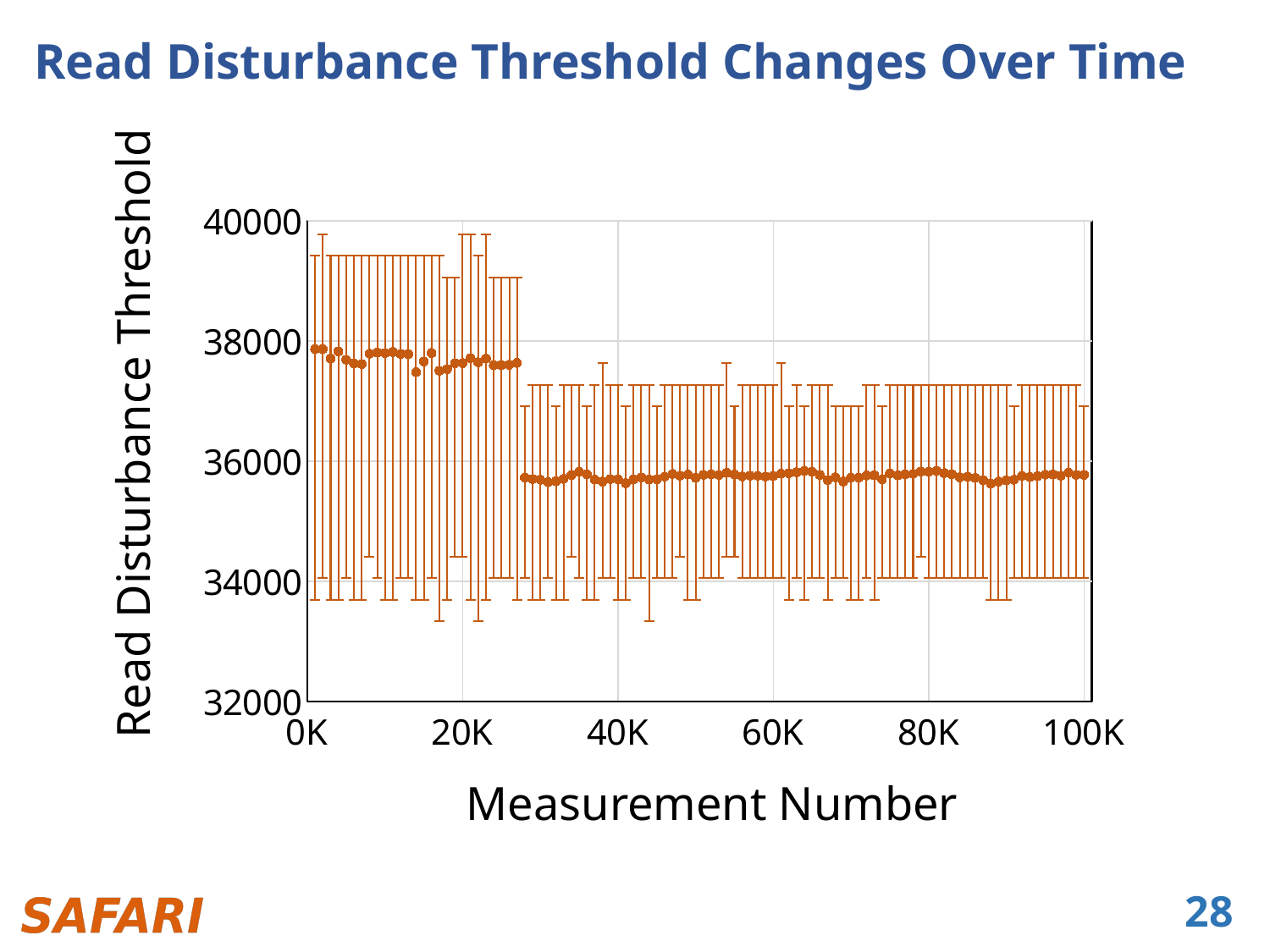
Which is larger, the Read Disturbance Threshold at measurement 10K or at measurement 50K? 10K Is the Read Disturbance Threshold at measurement 60K greater or less than 37000? less Is the Read Disturbance Threshold at measurement 10K greater or less than 37000? greater What kind of chart is shown on the slide? scatter chart with error bars What is the label of the x axis of the chart? Measurement Number What is the title of the chart? Read Disturbance Threshold Changes Over Time Is the Read Disturbance Threshold at measurement 90K greater or less than 34000? greater How many data series are plotted in the chart? 1 Do the Read Disturbance Threshold values rise or fall as the measurement number increases? fall